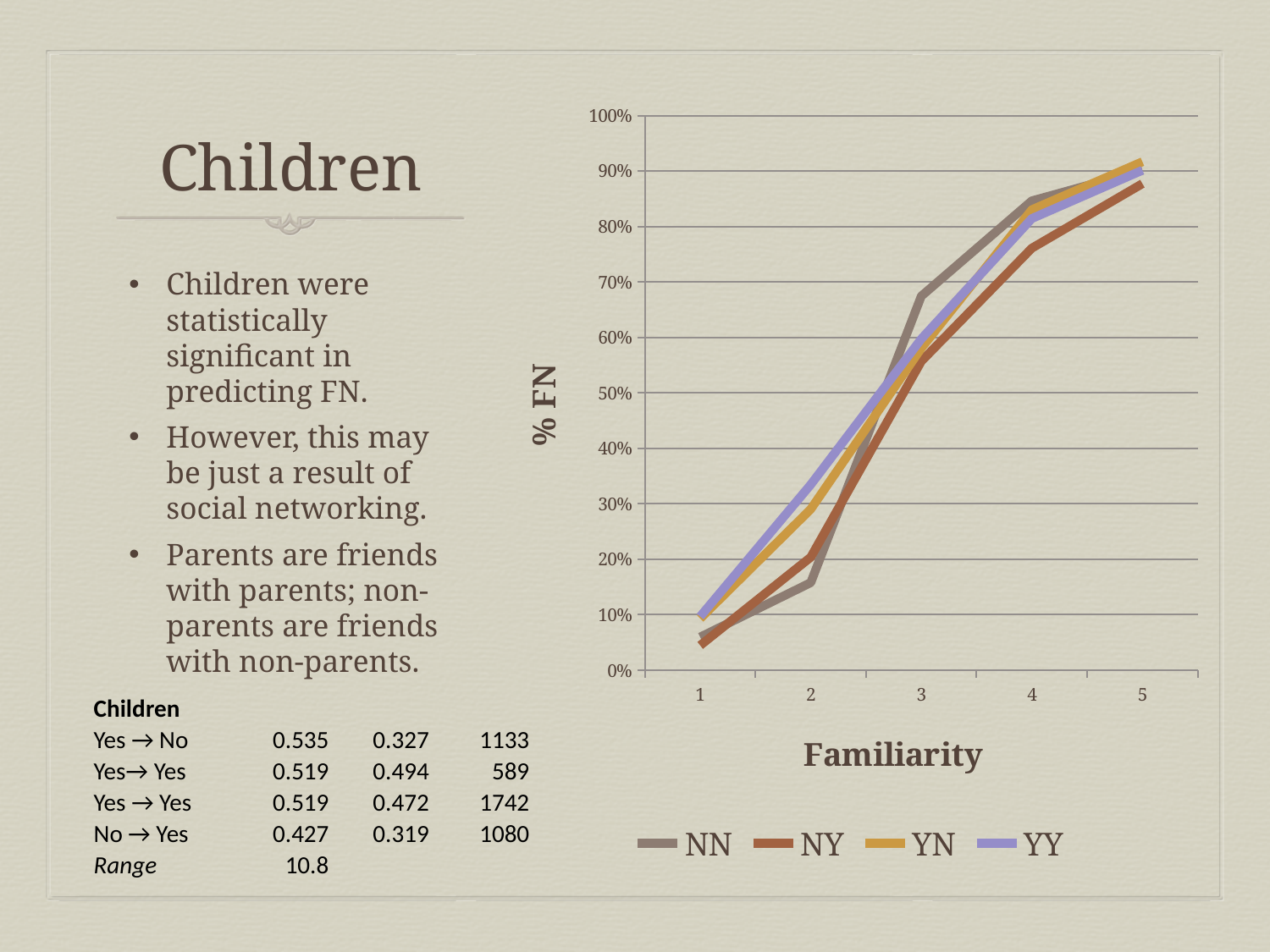
How many series does the chart legend list? 4 Is the value for YY at familiarity 2 greater or less than 20%? greater What is the title of the y axis? % FN Is the value for NY at familiarity 4 greater or less than 80%? less What kind of chart is shown on the slide? line chart What is the title of the x axis? Familiarity At familiarity 4, which series has the lowest value? NY Do the values for the NY series rise or fall as familiarity increases from 1 to 5? rise At familiarity 3, which series has the larger value, NN or NY? NN Is the value for NN at familiarity 3 greater or less than 60%? greater How many familiarity levels are plotted along the x axis? 5